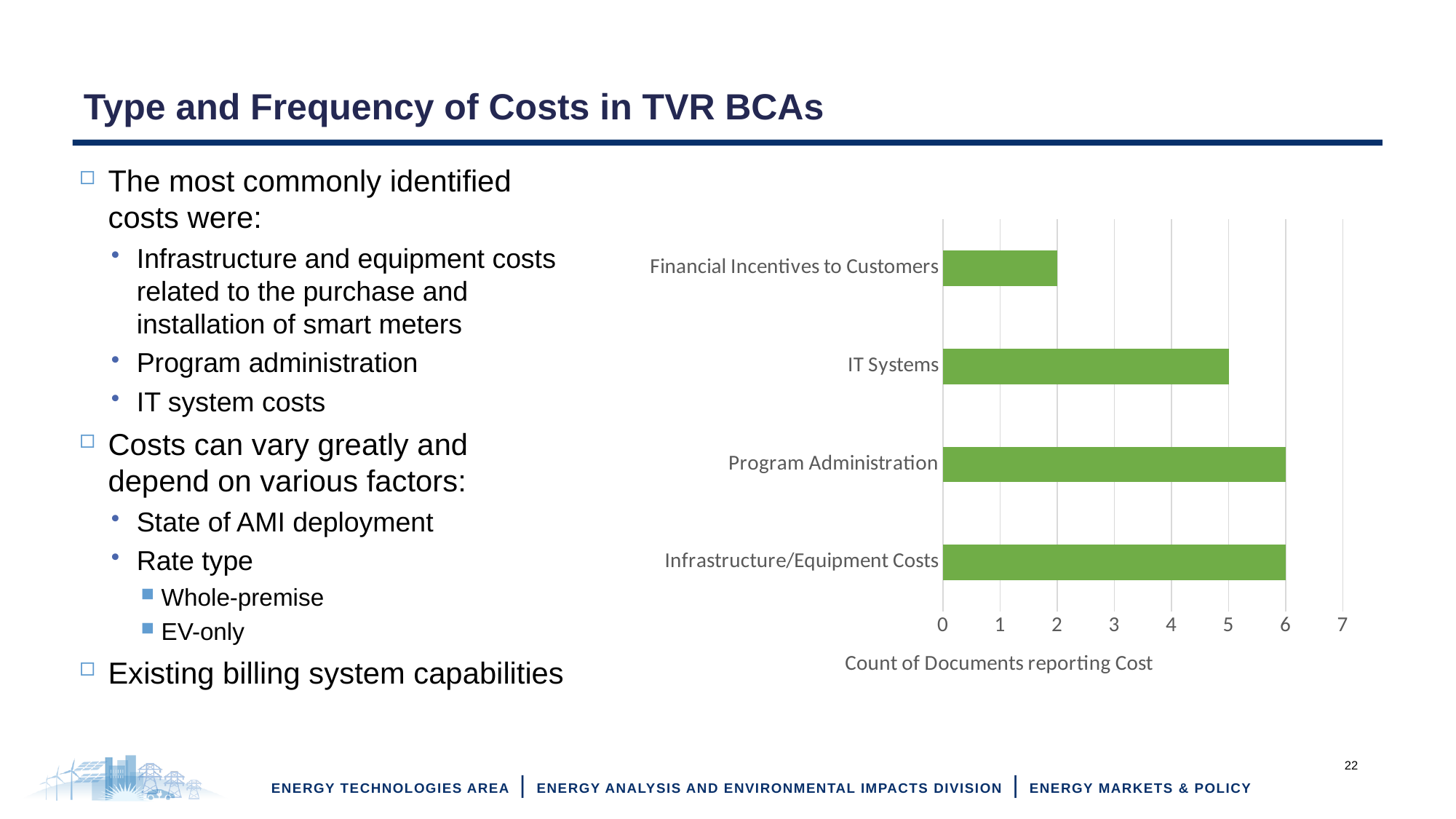
Which has a higher count of documents, IT Systems or Financial Incentives to Customers? IT Systems How many cost categories are shown in the chart? 4 What is the count of documents reporting cost for Program Administration? 6 What is the difference between the counts for IT Systems and Financial Incentives to Customers? 3 What is the count of documents reporting cost for IT Systems? 5 What is the difference between the counts for Program Administration and IT Systems? 1 What is the count of documents reporting cost for Financial Incentives to Customers? 2 What kind of chart is shown on the slide? bar chart What is the title of the horizontal axis of the chart? Count of Documents reporting Cost Which cost category has the lowest count of documents reporting it? Financial Incentives to Customers Is the value for Financial Incentives to Customers greater or less than 3? less What is the count of documents reporting cost for Infrastructure/Equipment Costs? 6